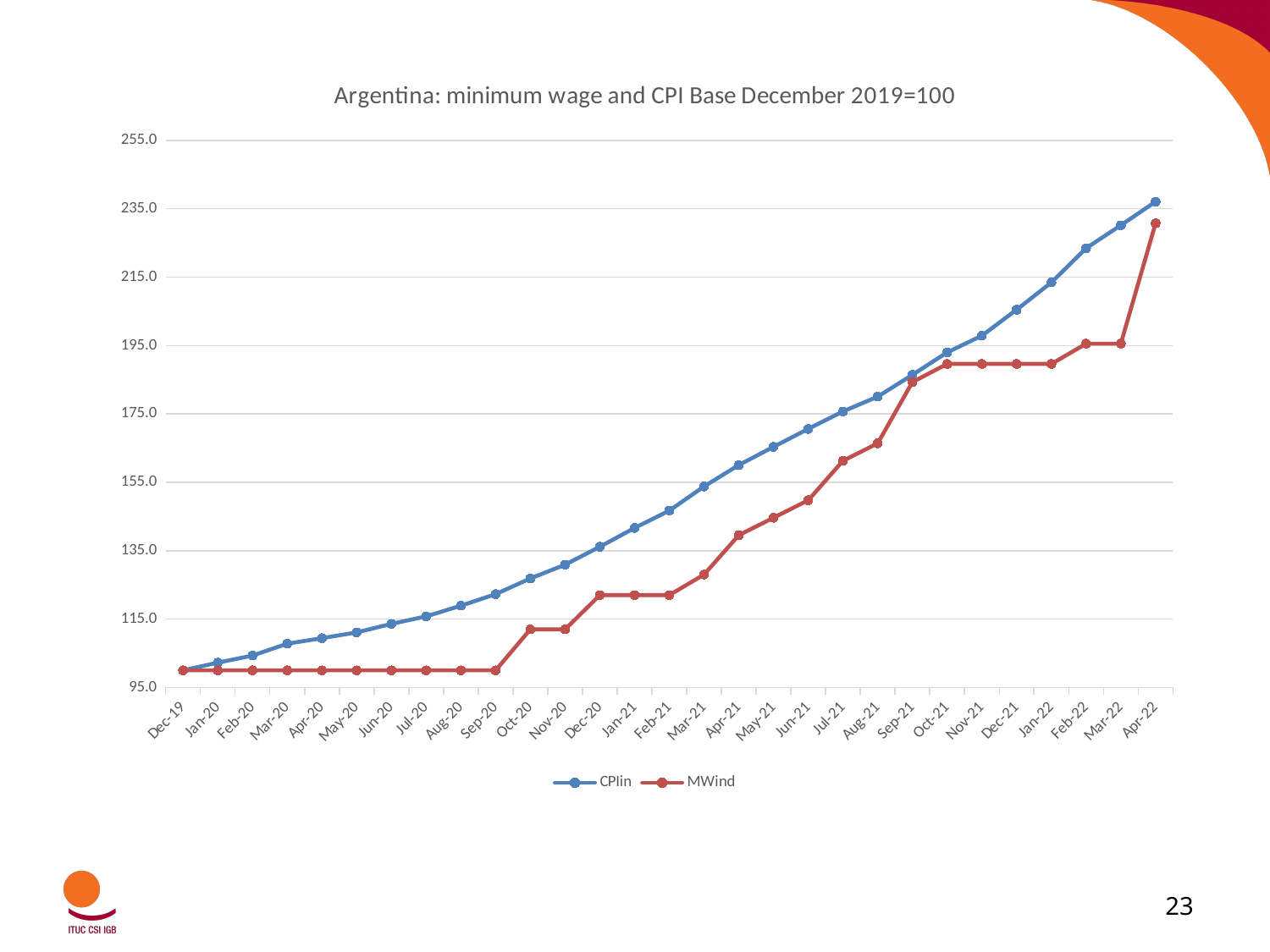
Is the MWind value for Sep-20 greater or less than 115? less What kind of chart is shown on the slide? Line chart In which month does the CPIin series reach its highest value? Apr-22 Do the CPIin values rise or fall from Dec-19 to Apr-22? Rise In Apr-22, which series has the higher value, CPIin or MWind? CPIin What is the title of the chart? Argentina: minimum wage and CPI Base December 2019=100 Is the MWind value for Nov-21 greater or less than 195? less In Jul-21, which series has the higher value, CPIin or MWind? CPIin How many monthly points are plotted along the x axis, from Dec-19 to Apr-22? 29 What are the names of the two series in the legend? CPIin and MWind How many series does the legend list? 2